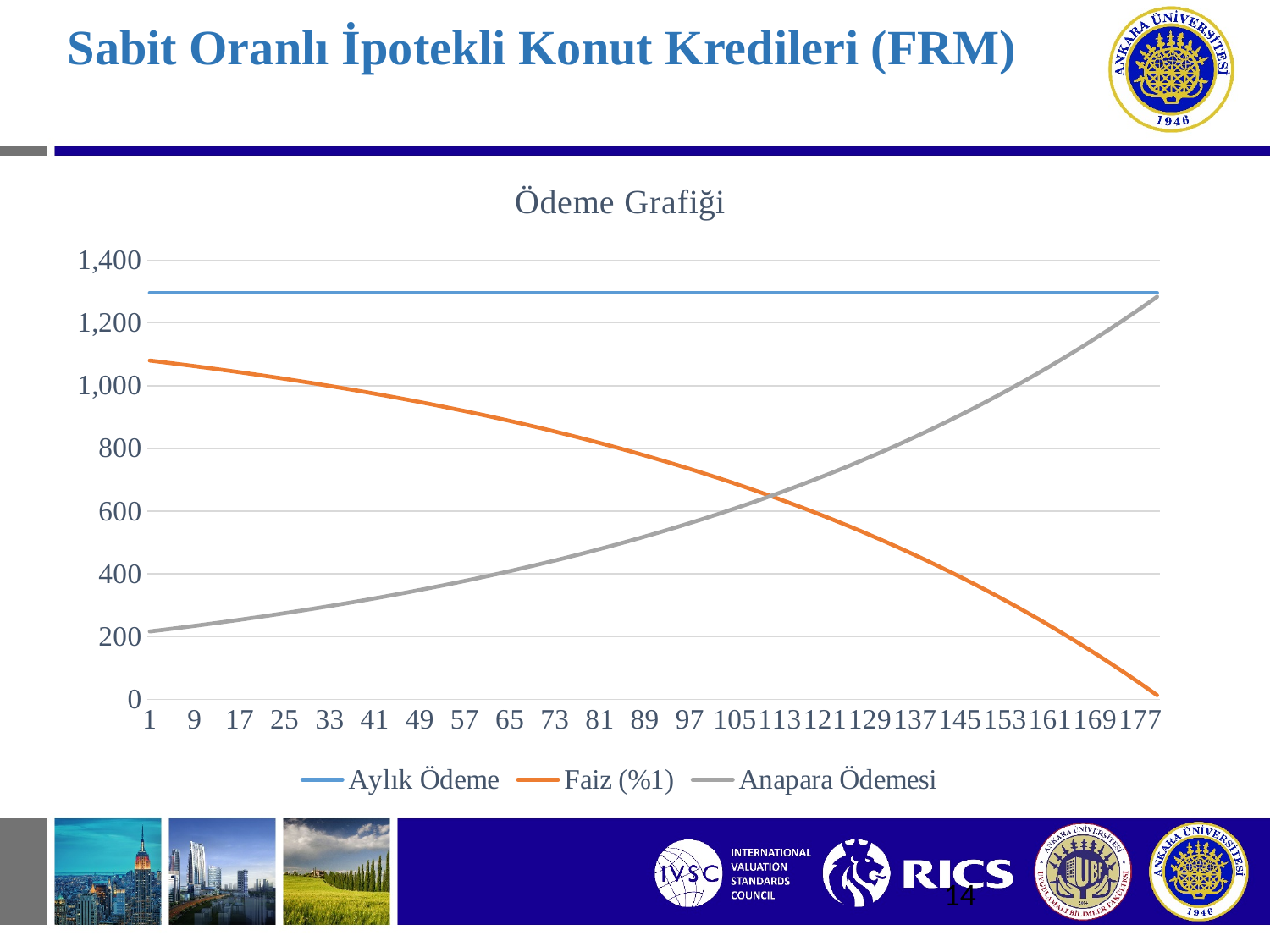
What kind of chart is shown on the slide? line chart Is the value of Anapara Ödemesi at x = 1 greater or less than 400? less Does the Anapara Ödemesi series rise or fall along the x axis? rise What is the title of the chart? Ödeme Grafiği At x = 1, which is larger: Faiz (%1) or Anapara Ödemesi? Faiz (%1) Does the Faiz (%1) series rise or fall along the x axis? fall Is the value of Aylık Ödeme at x = 1 greater or less than 1,200? greater At x = 177, which is larger: Faiz (%1) or Anapara Ödemesi? Anapara Ödemesi Is the value of Faiz (%1) at x = 1 greater or less than 1,000? greater How many series does the legend list? 3 Which series is shown in orange? Faiz (%1)